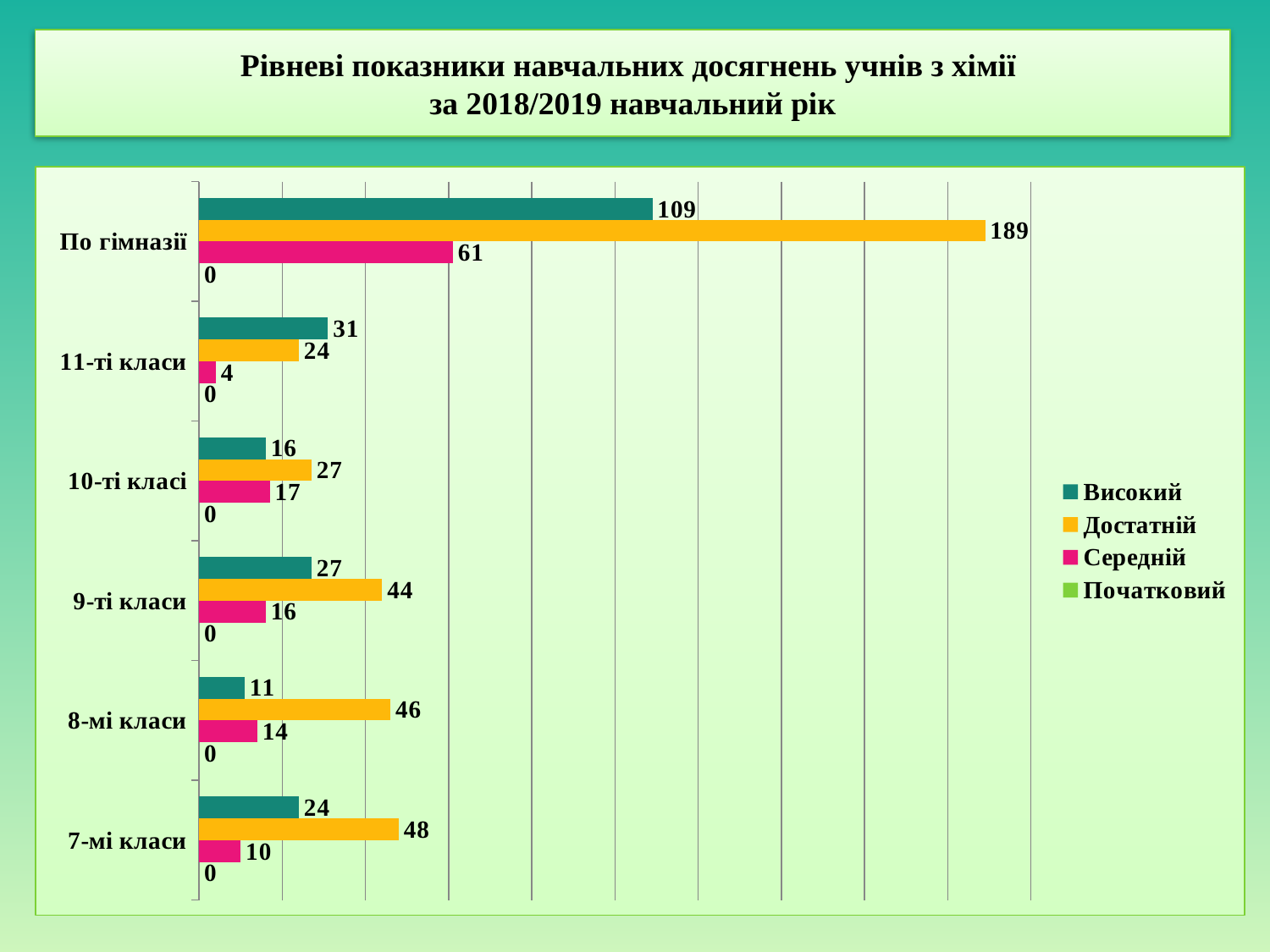
What is the value of Високий for 11-ті класи? 31 Which is larger for 10-ті класі: Високий or Середній? Середній What is the value of Достатній for По гімназії? 189 How many series does the legend list? 4 What is the value of Початковий for 9-ті класи? 0 What kind of chart is shown on the slide? bar chart What is the title of the chart on the slide? Рівневі показники навчальних досягнень учнів з хімії за 2018/2019 навчальний рік How many categories are shown on the vertical axis? 6 Among the class categories (excluding По гімназії), which has the lowest value for Середній? 11-ті класи Which category has the highest value for Достатній? По гімназії What is the value of Середній for 7-мі класи? 10 What is the difference between Достатній and Високий for 8-мі класи? 35